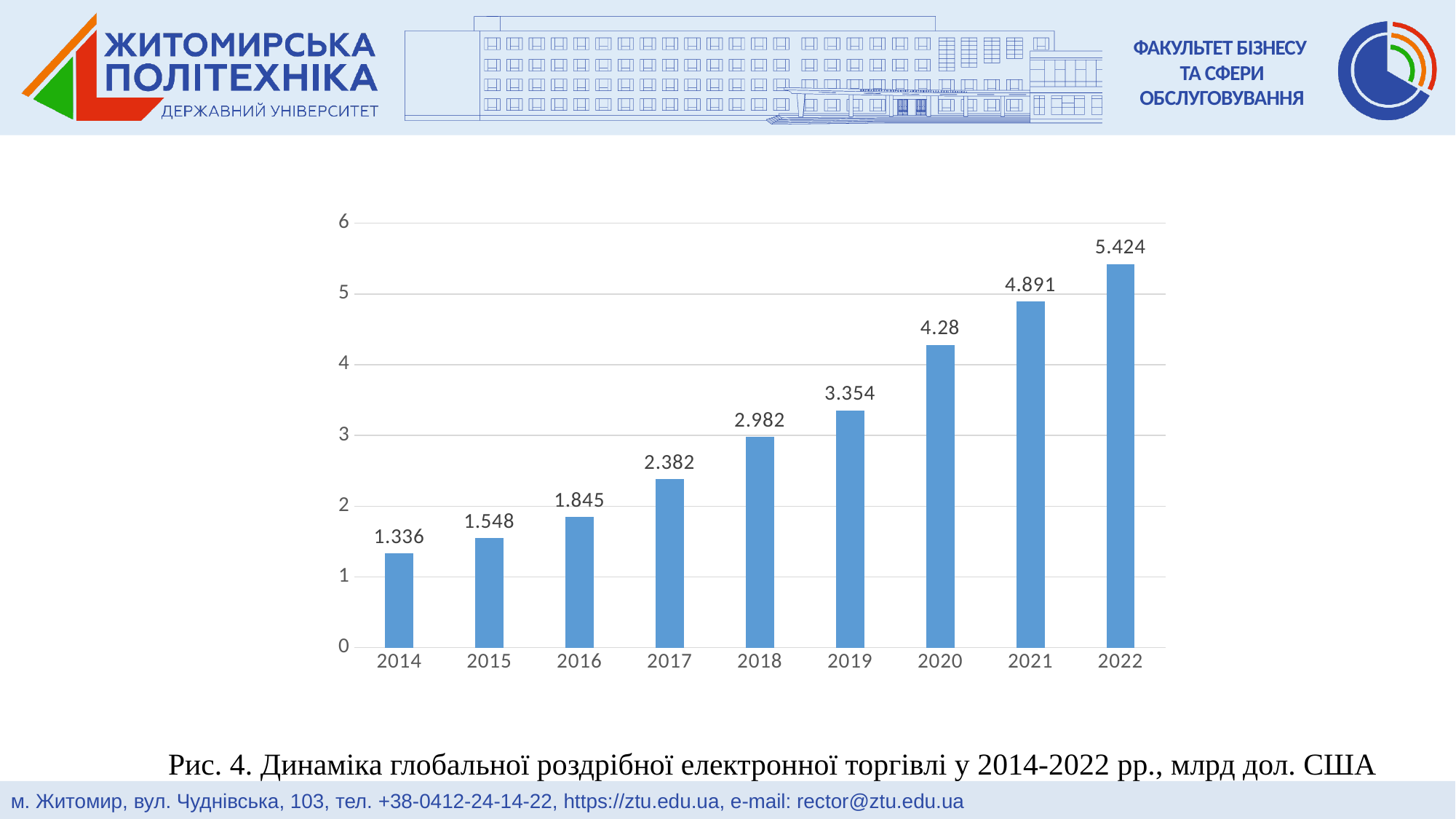
How many years are shown on the x axis? 9 Which is larger, the value for 2017 or the value for 2019? 2019 Which year has the highest value? 2022 What is the value for 2022? 5.424 What is the value for 2018? 2.982 What is the value for 2014? 1.336 Which year has the lowest value? 2014 What is the value for 2020? 4.28 What is the difference between the values for 2022 and 2021? 0.533 What kind of chart is shown on the slide? bar chart Do the values rise or fall from 2014 to 2022? rise What is the difference between the values for 2019 and 2014? 2.018